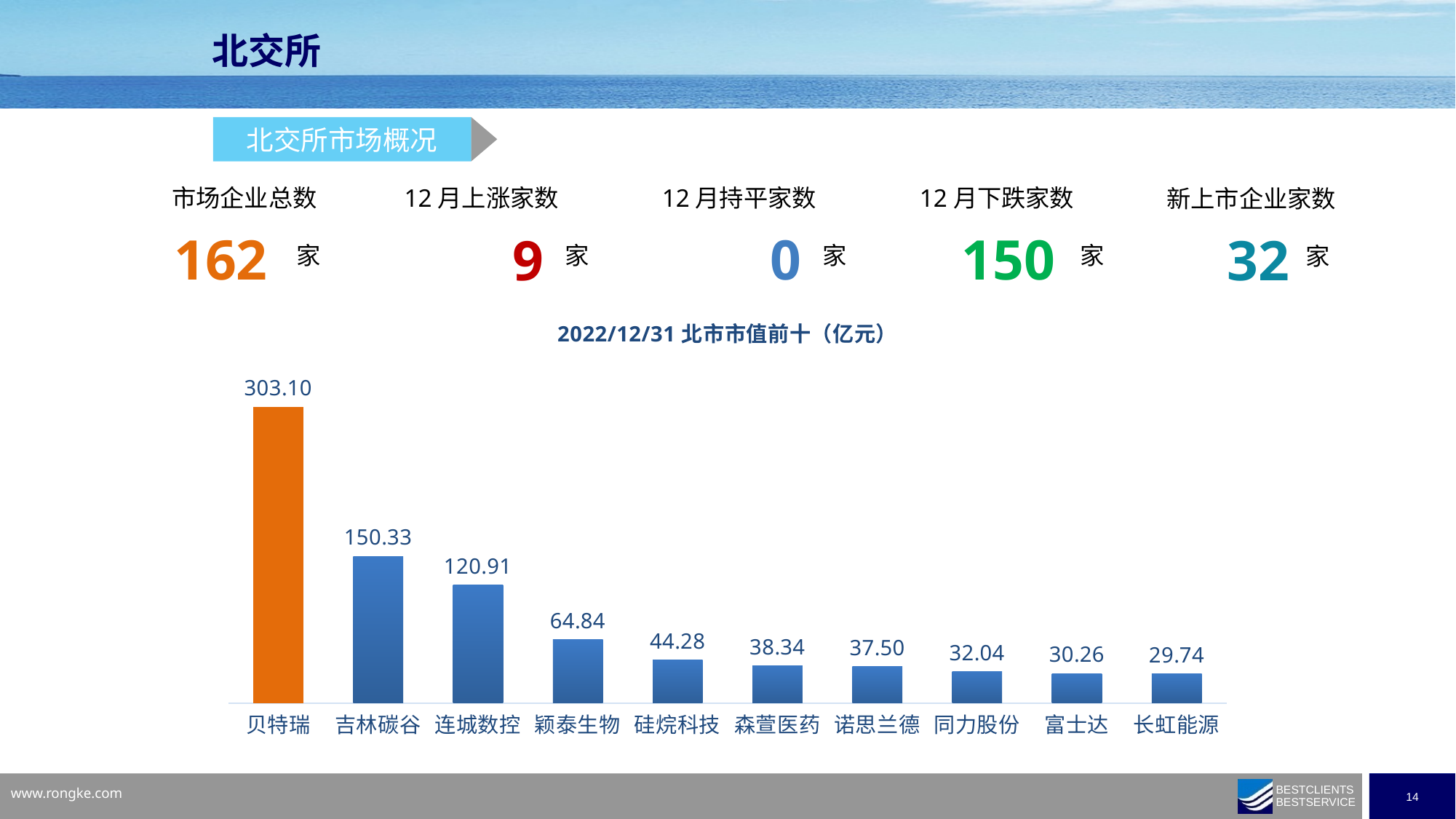
Which is larger, the value for 吉林碳谷 or the value for 连城数控? 吉林碳谷 Which company has the lowest value in the chart? 长虹能源 What is the difference between the values for 贝特瑞 and 吉林碳谷? 152.77 What is the value for 诺思兰德? 37.50 Which company has the highest value in the chart? 贝特瑞 What is the title of the chart? 2022/12/31 北市市值前十（亿元） What is the value for 连城数控? 120.91 What is the value for 贝特瑞? 303.10 Do the values rise or fall from left to right along the x axis? fall What type of chart is shown on the slide? bar chart What is the difference between the values for 颖泰生物 and 硅烷科技? 20.56 How many companies are shown in the chart? 10